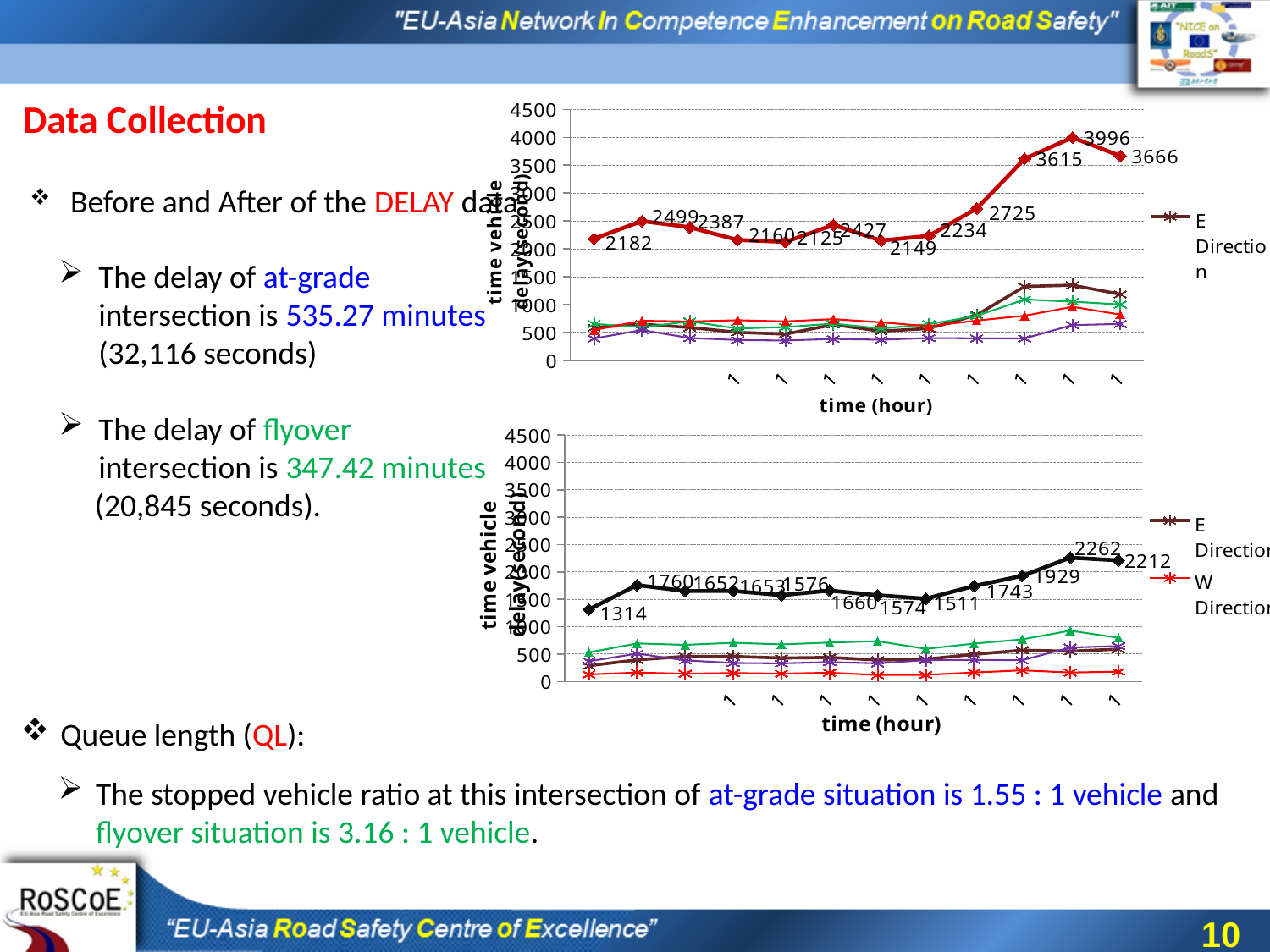
In the top chart, is the first labelled value (2182) or the last labelled value (3666) of the red diamond series larger? 3666 What is the x-axis title of the bottom chart? time (hour) How many data points are labelled on the top series of the bottom chart? 12 In the bottom chart, what is the highest labelled value on the top (black diamond) series? 2262 In the bottom chart, what is the difference between the highest labelled value (2262) and the lowest labelled value (1314)? 948 In the bottom chart, is the W Direction (red star) series greater or less than 500 throughout? less In the bottom chart, what is the lowest labelled value on the top (black diamond) series? 1314 Which two legend entries are shown for the bottom chart? E Direction and W Direction In the top chart, what is the lowest labelled value on the top (red diamond) series? 2125 What kind of chart is the top chart on the slide? line chart In the top chart, what is the difference between the last two labelled values, 3996 and 3666? 330 In the top chart, what is the highest labelled value on the top (red diamond) series? 3996